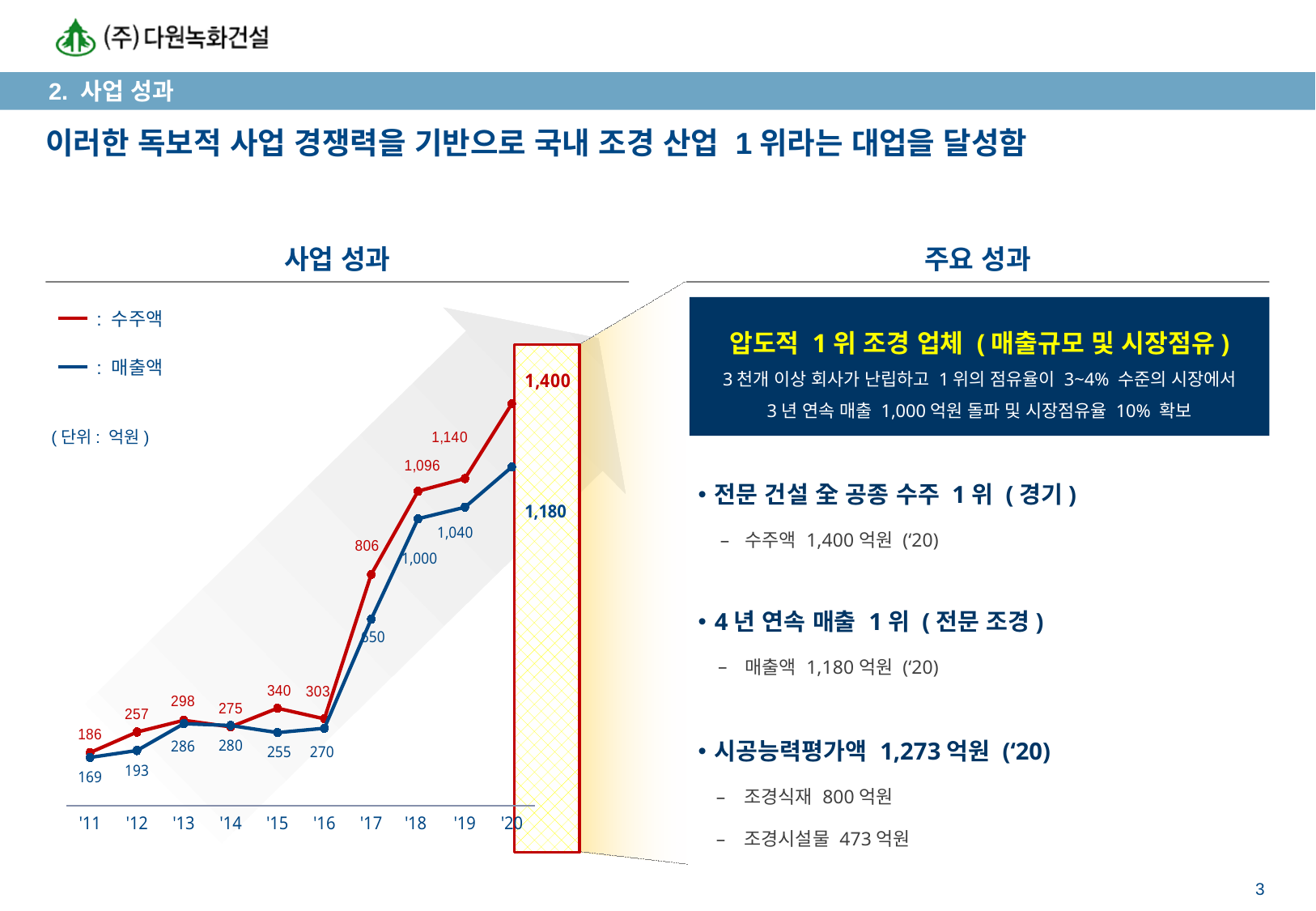
What is the 매출액 value for '18 in the 사업 성과 chart? 1,000 What is the 수주액 value for '20 in the 사업 성과 chart? 1,400 In which year is 수주액 highest in the 사업 성과 chart? '20 How many years are shown on the x axis of the 사업 성과 chart? 10 What type of chart is shown under the heading 사업 성과? line chart What is the 수주액 value for '17 in the 사업 성과 chart? 806 What colour is the 수주액 line in the 사업 성과 chart? red What is the difference between 수주액 and 매출액 in '20 in the 사업 성과 chart? 220 Which is larger in '15 in the 사업 성과 chart, 수주액 or 매출액? 수주액 How many series does the legend of the 사업 성과 chart list? 2 In which year is 매출액 lowest in the 사업 성과 chart? '11 What is the 매출액 value for '11 in the 사업 성과 chart? 169